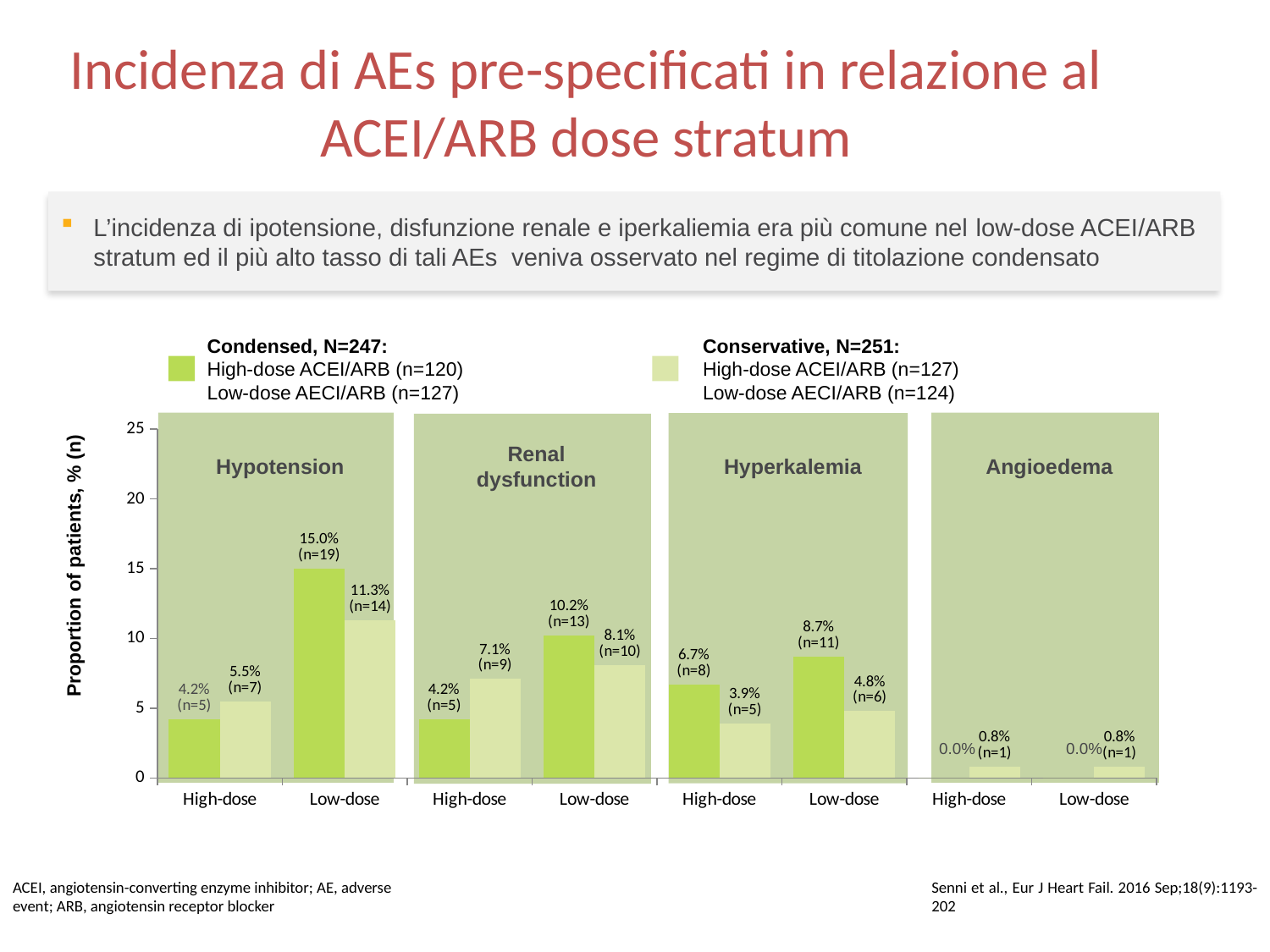
Which bar in the chart shows the highest proportion of patients? Hypotension, Low-dose, Condensed (15.0%) What is the proportion of patients with angioedema in the High-dose group of the Condensed regimen? 0.0% What is the proportion of patients with renal dysfunction in the High-dose group of the Conservative regimen? 7.1% What type of chart is shown on the slide? Bar chart How many patients (n) had hyperkalemia in the Low-dose group of the Condensed regimen? n=11 For renal dysfunction in the Low-dose group, which regimen has the larger proportion, Condensed or Conservative? Condensed How many adverse event panels are shown in the chart? 4 Is the proportion of patients with hypotension in the Low-dose Condensed group greater or less than 10? greater For hyperkalemia in the High-dose group, which regimen has the larger proportion, Condensed or Conservative? Condensed What is the proportion of patients with hypotension in the Low-dose group of the Condensed regimen? 15.0% What is the difference between the Condensed and Conservative proportions for hypotension in the Low-dose group? 3.7% What is the label of the y axis of the chart? Proportion of patients, % (n)